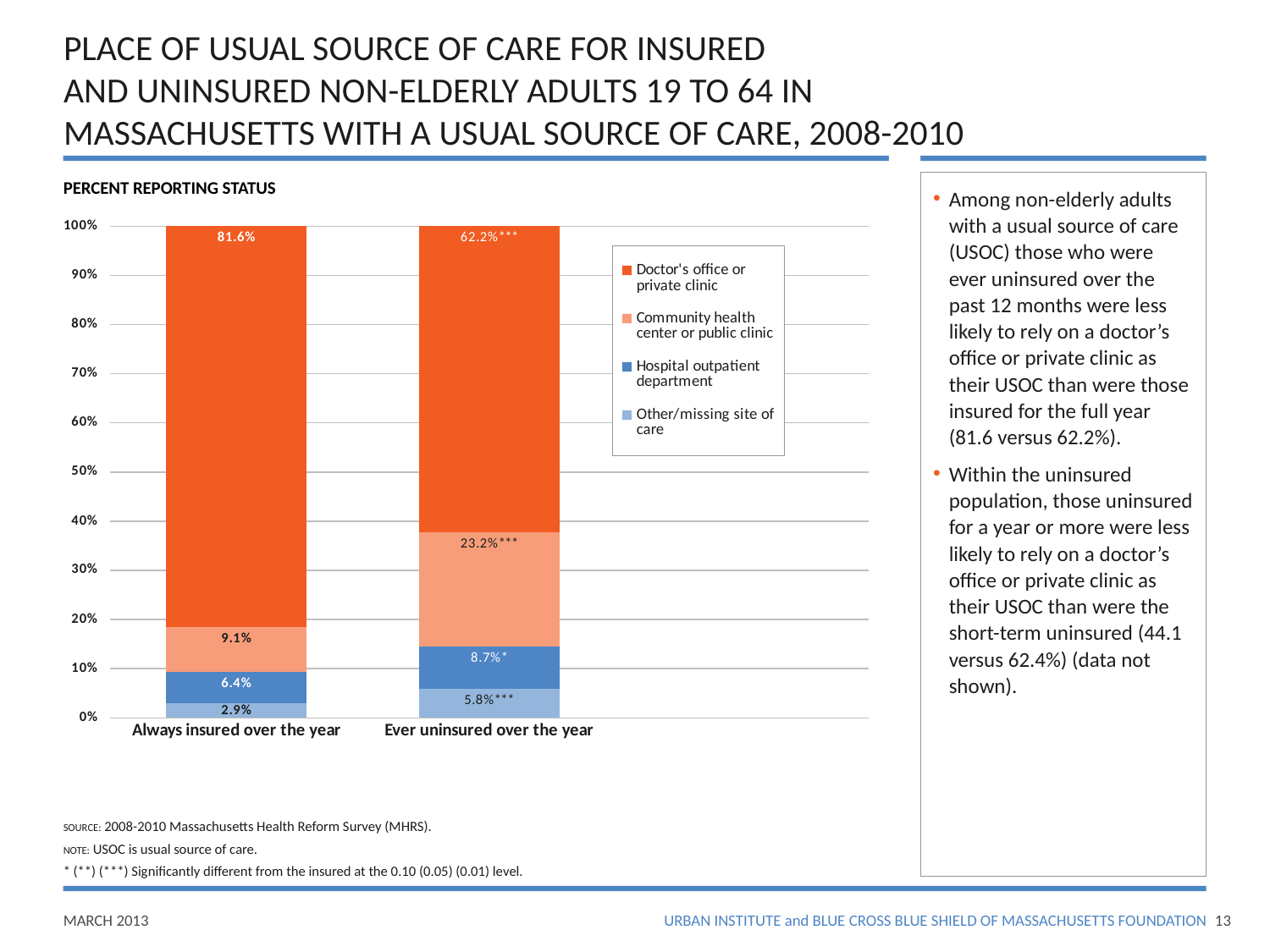
Which group has a larger share reporting a community health center or public clinic: always insured or ever uninsured over the year? Ever uninsured over the year What is the value for hospital outpatient department among adults always insured over the year? 6.4% What type of chart is shown on the slide? Stacked bar chart What is the value for community health center or public clinic among adults ever uninsured over the year? 23.2% Which usual source of care has the largest share among adults always insured over the year? Doctor's office or private clinic How many series does the legend list? 4 How many categories are shown on the x axis? 2 Which usual source of care has the smallest share among adults always insured over the year? Other/missing site of care What is the value for other/missing site of care among adults ever uninsured over the year? 5.8% What percentage of adults always insured over the year reported a doctor's office or private clinic as their usual source of care? 81.6% What is the difference in the doctor's office or private clinic share between adults always insured and adults ever uninsured over the year? 19.4 percentage points What percentage of adults ever uninsured over the year reported a doctor's office or private clinic as their usual source of care? 62.2%